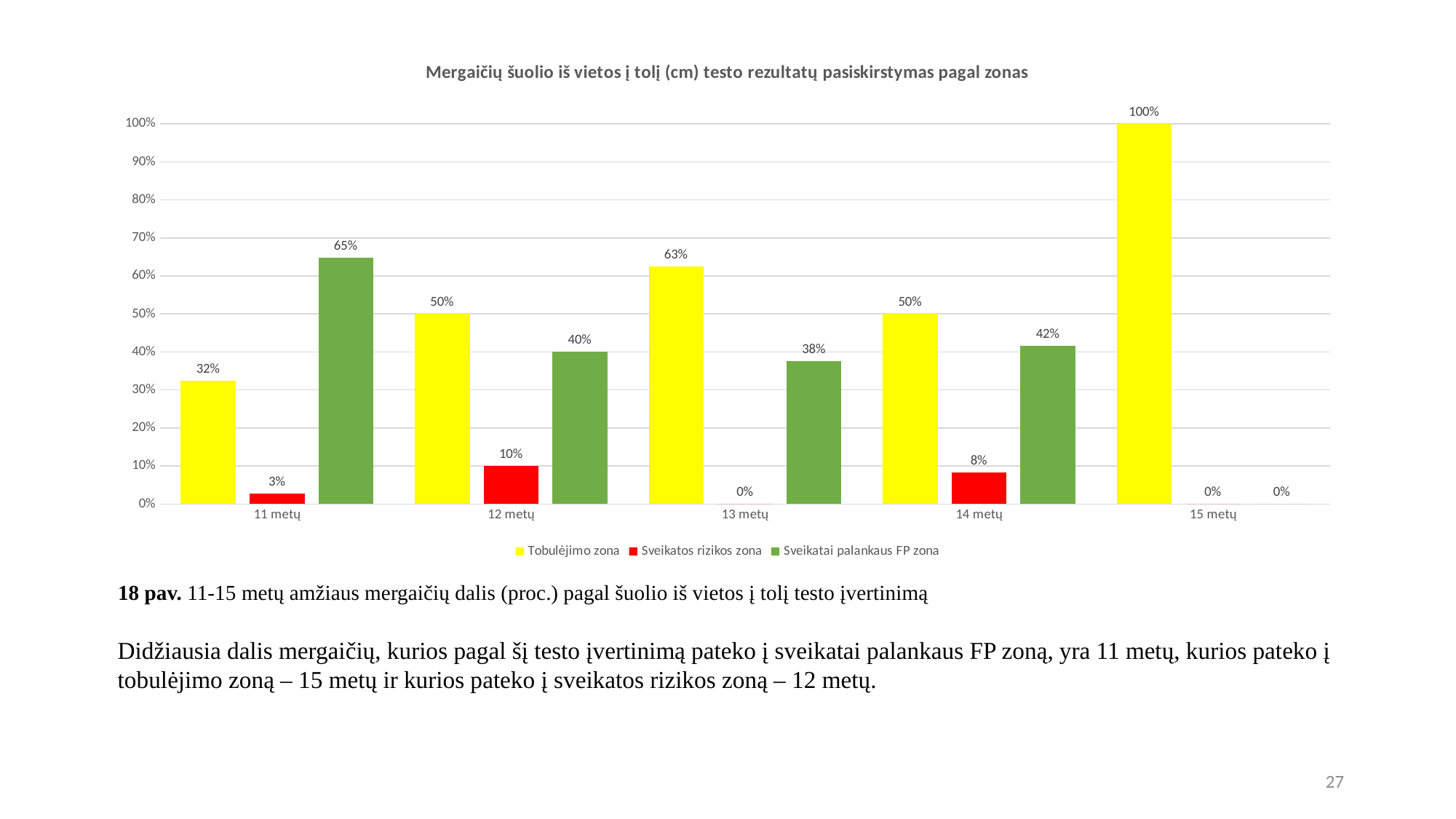
What is the difference between Sveikatai palankaus FP zona and Tobulėjimo zona at 11 metų? 33% What is the value for Tobulėjimo zona at 11 metų? 32% Which is larger at 12 metų: Tobulėjimo zona or Sveikatai palankaus FP zona? Tobulėjimo zona What is the value for Tobulėjimo zona at 13 metų? 63% Which age group has the highest value for Sveikatos rizikos zona? 12 metų What is the value for Sveikatai palankaus FP zona at 11 metų? 65% Which age group has the highest value for Tobulėjimo zona? 15 metų What is the value for Sveikatai palankaus FP zona at 14 metų? 42% What is the value for Sveikatos rizikos zona at 12 metų? 10% How many series does the legend list? 3 What kind of chart is shown on the slide? Bar chart How many age groups are shown on the x axis? 5